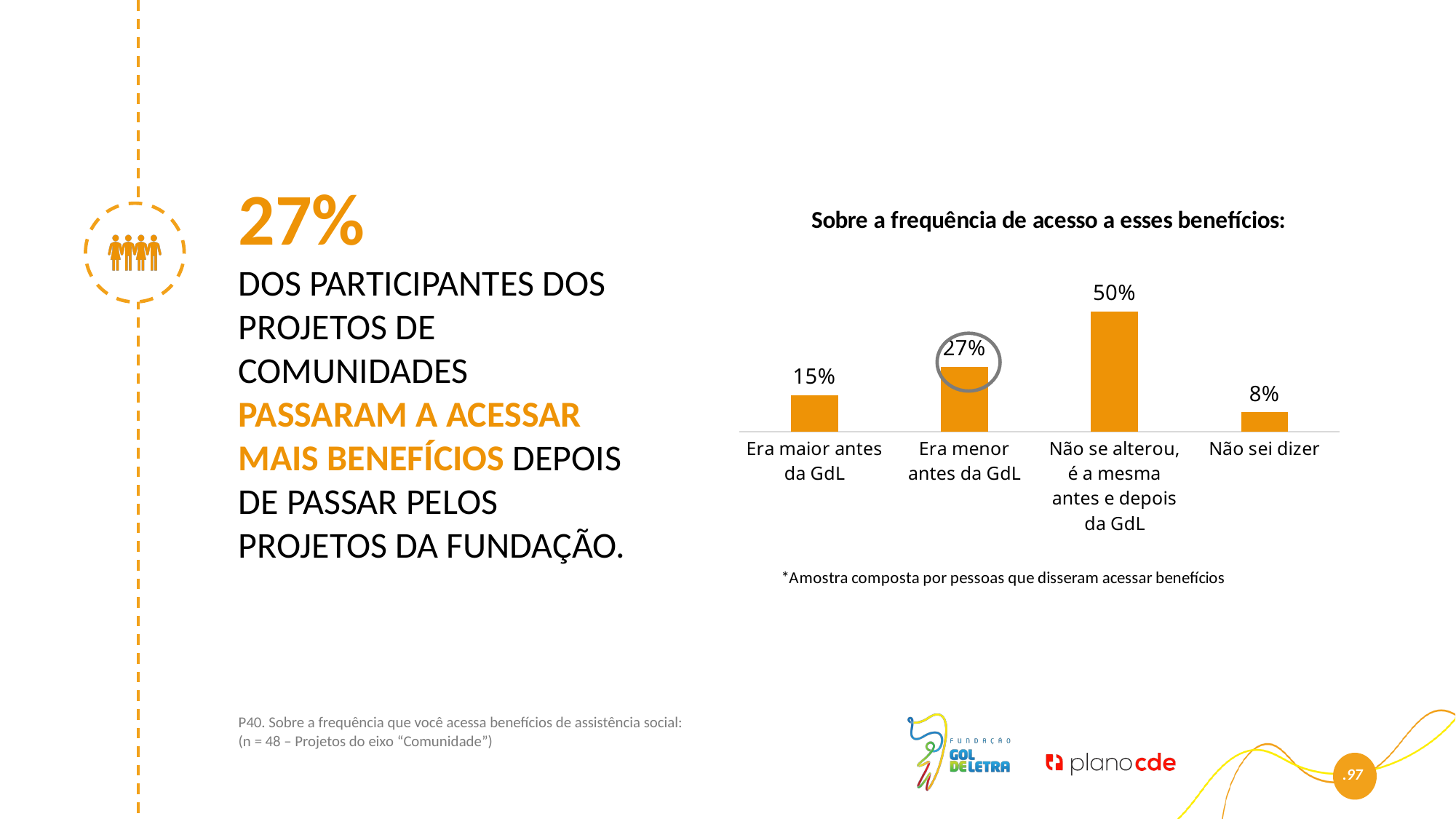
What is the value for "Não se alterou, é a mesma antes e depois da GdL"? 50% What is the title of the chart? Sobre a frequência de acesso a esses benefícios: Which is larger, "Era maior antes da GdL" or "Era menor antes da GdL"? Era menor antes da GdL What is the difference between "Não se alterou, é a mesma antes e depois da GdL" and "Era menor antes da GdL"? 23% Which category has the highest value? Não se alterou, é a mesma antes e depois da GdL How many categories are shown in the chart? 4 What is the value for "Era menor antes da GdL"? 27% What is the difference between "Era menor antes da GdL" and "Era maior antes da GdL"? 12% What kind of chart is shown on the slide? Bar chart What is the value for "Não sei dizer"? 8% What is the value for "Era maior antes da GdL"? 15% Which category has the lowest value? Não sei dizer